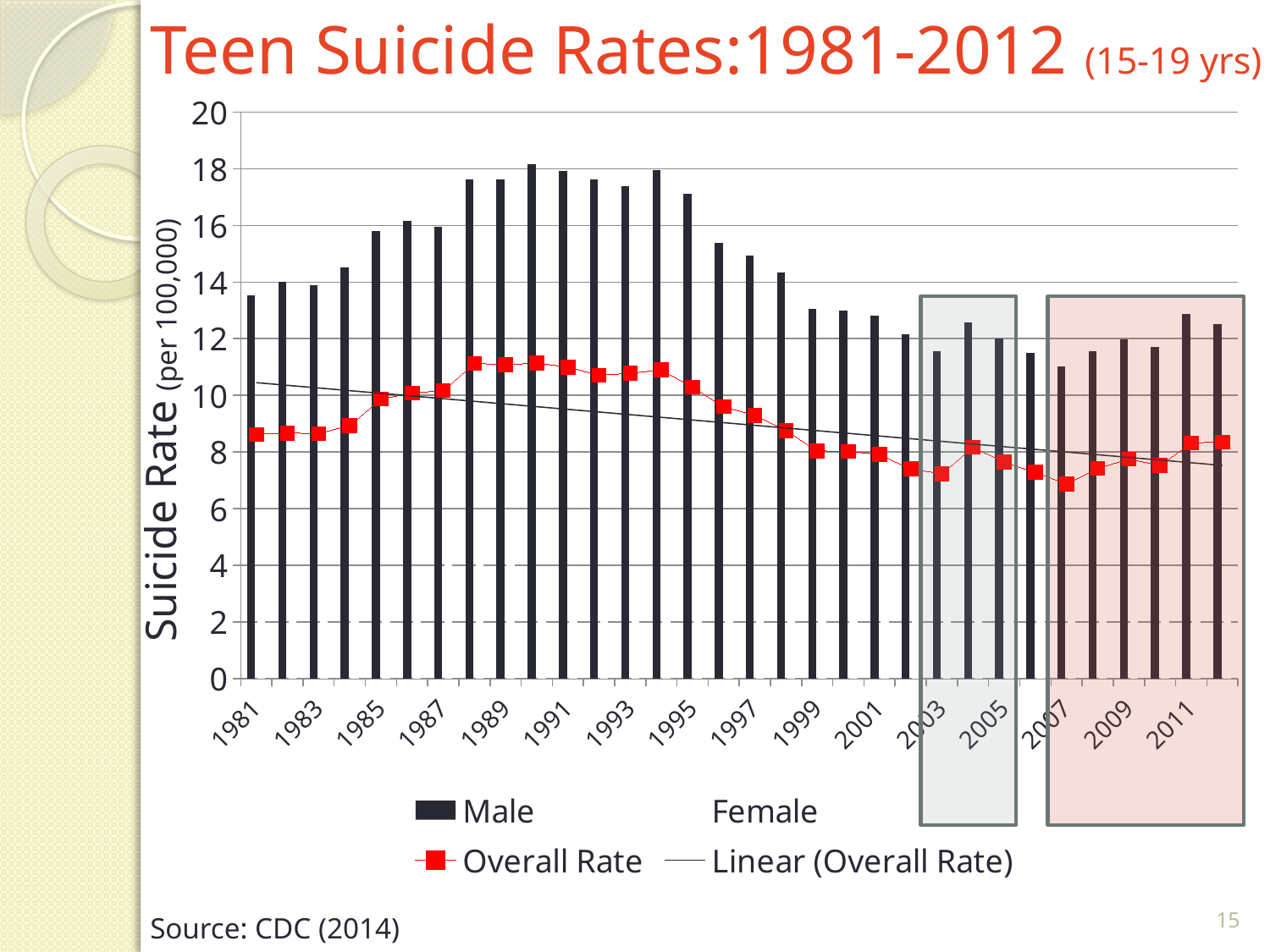
Does the Overall Rate rise or fall from 1995 to 2007? fall In which year is the Male bar highest? 1990 In which year is the Male bar lowest? 2007 Which year has the larger Male value, 1989 or 2007? 1989 Is the Male value for 1995 greater or less than 16? greater What kind of chart is shown on the slide? bar chart with a line In which year is the Overall Rate lowest? 2007 Is the Male value for 1981 greater or less than 14? less How many series does the legend list? 4 Is the Overall Rate for 1981 greater or less than 8? greater What is the y-axis title of the chart? Suicide Rate (per 100,000)